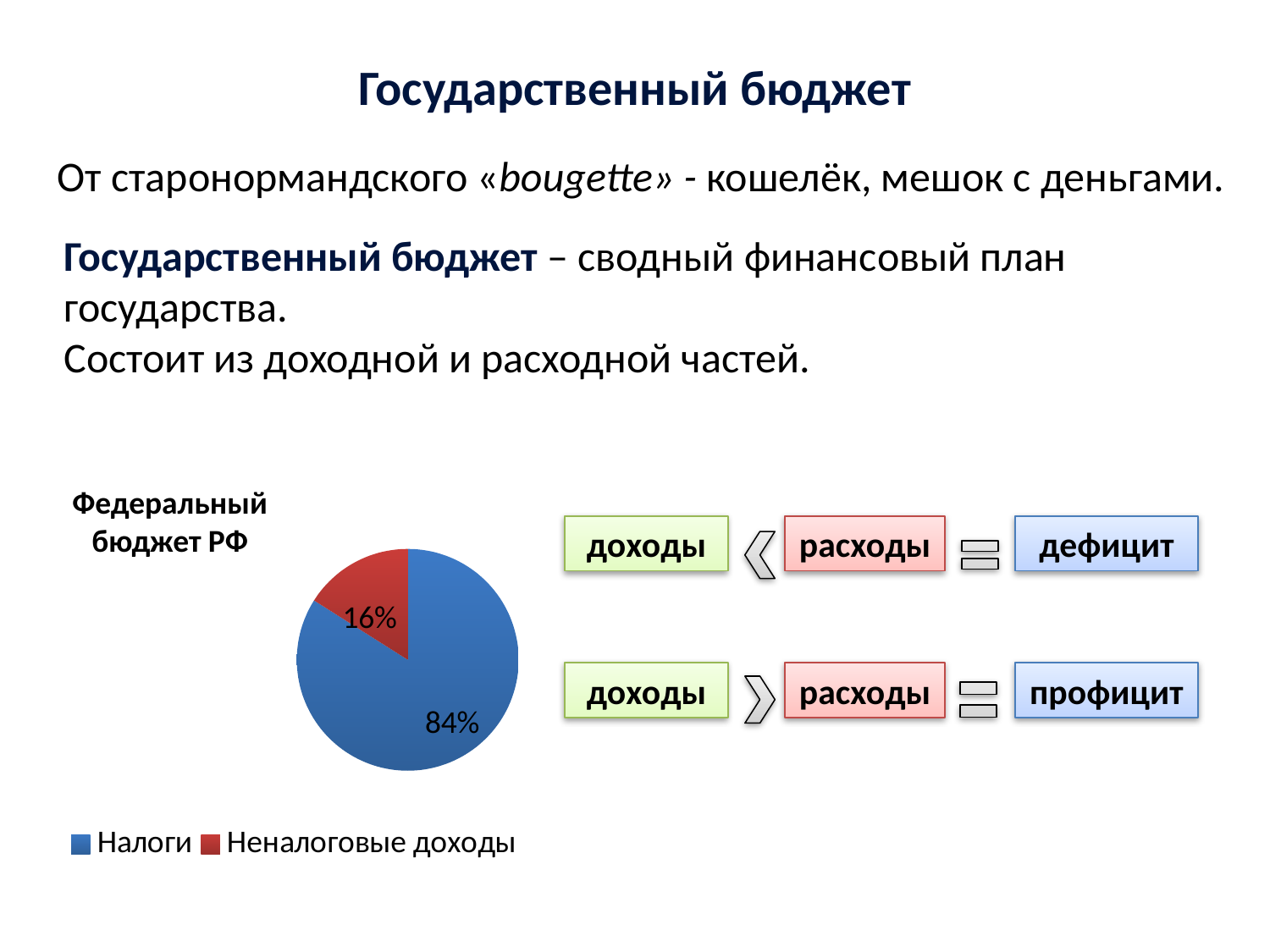
How many entries does the legend of the pie chart list? 2 What share of the pie chart does Налоги take? 84% Which is larger in the pie chart, Налоги or Неналоговые доходы? Налоги What is the difference in percentage points between the Налоги slice and the Неналоговые доходы slice? 68 What share of the pie chart does Неналоговые доходы take? 16% What kind of chart is shown on the slide? pie chart How many slices does the pie chart have? 2 What is the title of the pie chart? Федеральный бюджет РФ Which slice of the pie chart is the largest? Налоги Which slice of the pie chart is the smallest? Неналоговые доходы What colour is the Неналоговые доходы slice in the pie chart? red